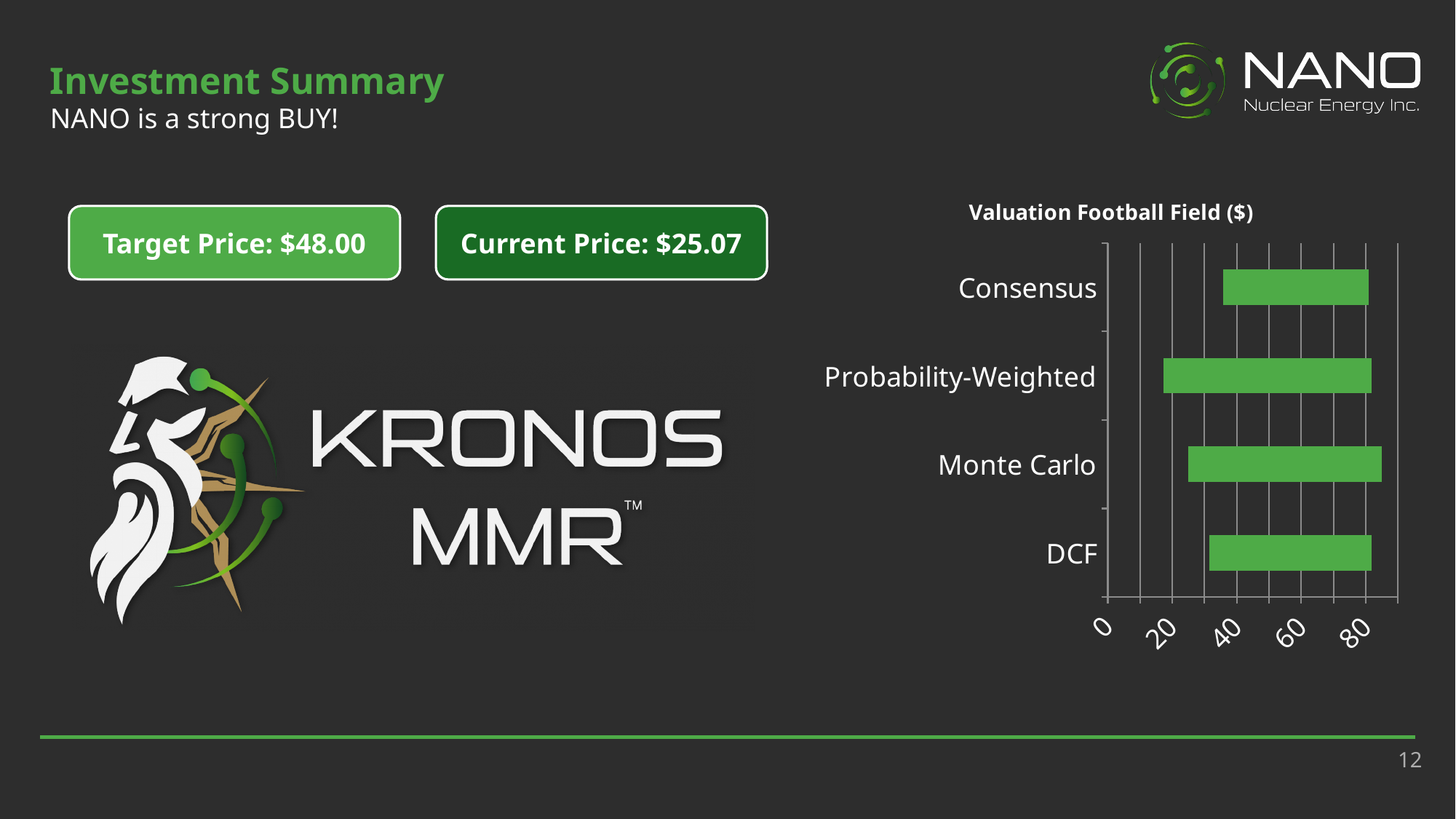
Is the lower end of the DCF bar greater or less than 20? greater Is the upper end of the Monte Carlo bar greater or less than 80? greater Is the upper end of the Consensus bar greater or less than 60? greater Which valuation method's bar extends furthest to the right on the Valuation Football Field ($) chart? Monte Carlo What kind of chart is the Valuation Football Field ($) chart? bar chart Which valuation method's bar starts furthest to the left on the Valuation Football Field ($) chart? Probability-Weighted Which bar starts further to the left on the Valuation Football Field ($) chart, Consensus or Monte Carlo? Monte Carlo How many valuation methods are listed on the Valuation Football Field ($) chart? 4 What is the title of the chart on the slide? Valuation Football Field ($) What colour are the bars on the Valuation Football Field ($) chart? green